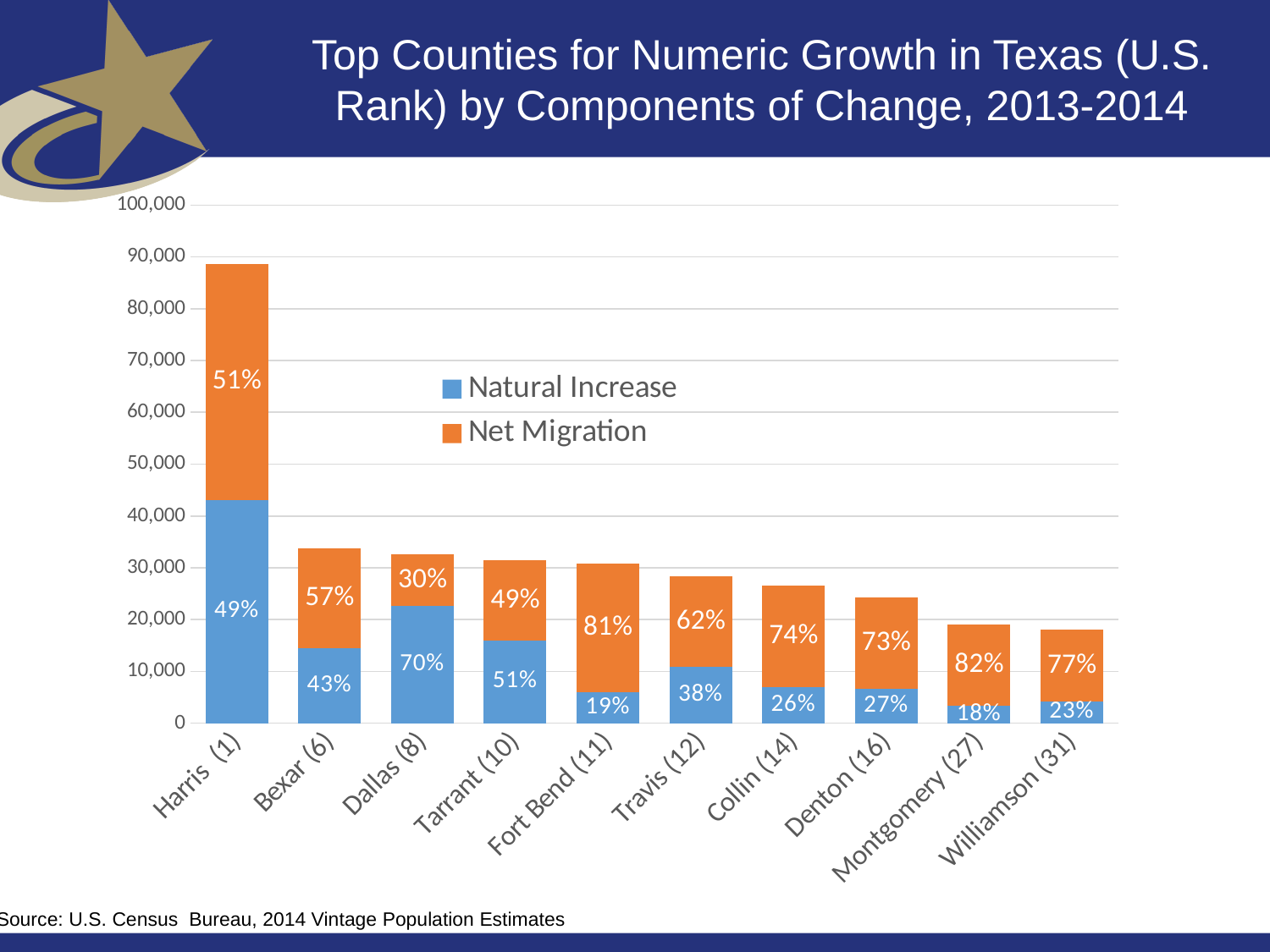
What percentage label is shown for Natural Increase in Harris (1)? 49% What percentage label is shown for Net Migration in Fort Bend (11)? 81% Which county has the tallest stacked bar (largest total numeric growth)? Harris (1) Which county shows the highest Net Migration percentage label? Montgomery (27) Which is larger for Bexar (6): the Natural Increase percentage or the Net Migration percentage? Net Migration How many series does the legend list? 2 How many counties are shown on the x axis? 10 Is the total bar height for Travis (12) greater or less than 30,000? less What percentage label is shown for Natural Increase in Dallas (8)? 70% Is the total bar height for Harris (1) greater or less than 80,000? greater What percentage label is shown for Net Migration in Williamson (31)? 77% Which county shows the lowest Natural Increase percentage label? Montgomery (27)